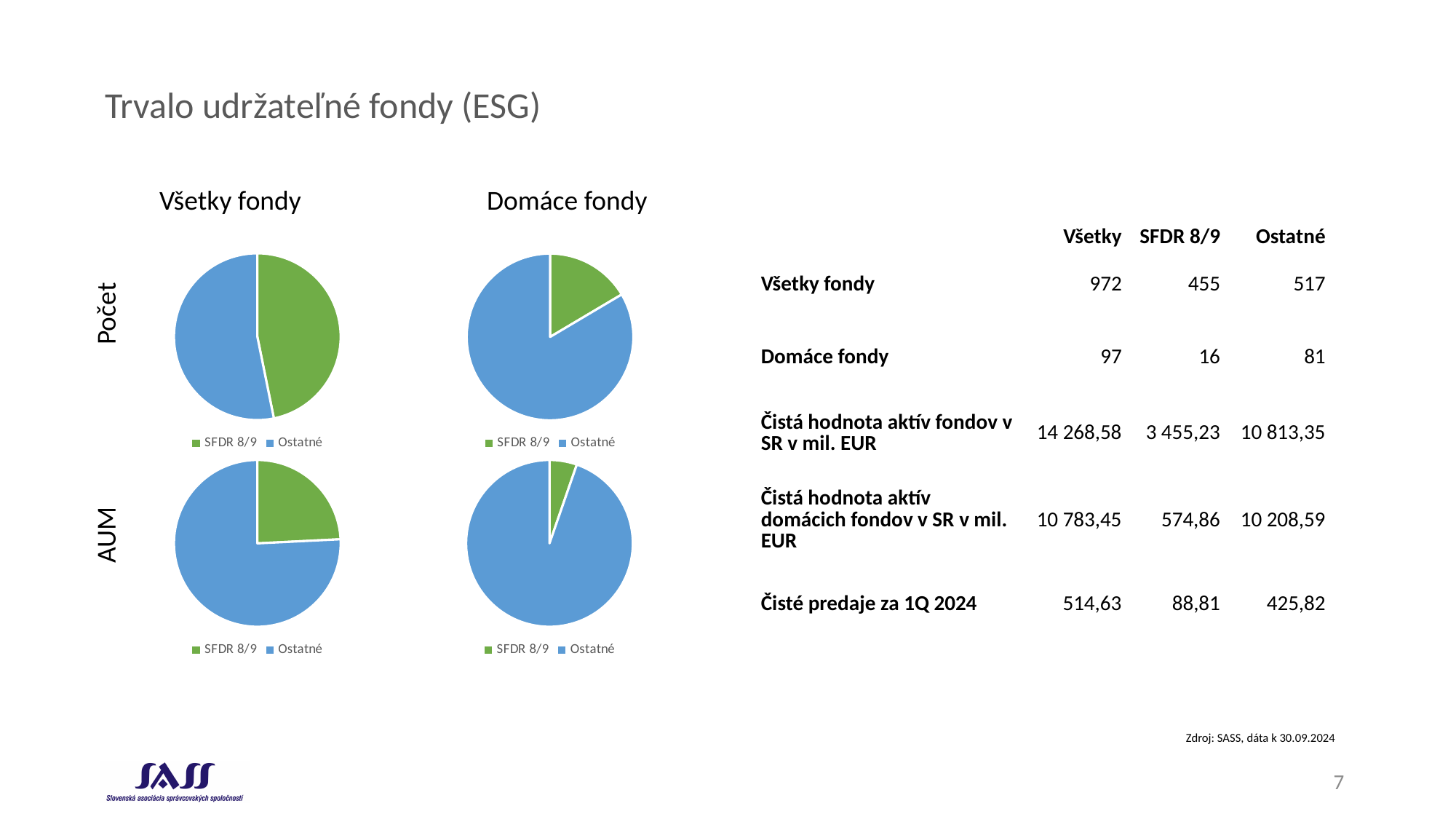
What colour represents SFDR 8/9 in the pie charts? green According to the table, how many SFDR 8/9 funds are there among Všetky fondy (the Počet / Všetky fondy pie)? 455 According to the table, what is the difference between the number of Ostatné and SFDR 8/9 funds among Všetky fondy? 62 What are the two column titles above the pie charts? Všetky fondy and Domáce fondy How many entries does the legend of the AUM / Domáce fondy pie chart list? 2 According to the table, how many Ostatné funds are there among Domáce fondy (the Počet / Domáce fondy pie)? 81 What kind of chart is used for the Počet / Všetky fondy chart? pie chart How many pie charts are shown on the slide? 4 In the Počet / Domáce fondy pie chart, which slice is the largest? Ostatné In the AUM / Domáce fondy pie chart, which slice is the smallest? SFDR 8/9 In the Počet / Všetky fondy pie chart, which slice is larger, SFDR 8/9 or Ostatné? Ostatné In the AUM / Všetky fondy pie chart, is the SFDR 8/9 slice larger or smaller than the Ostatné slice? smaller